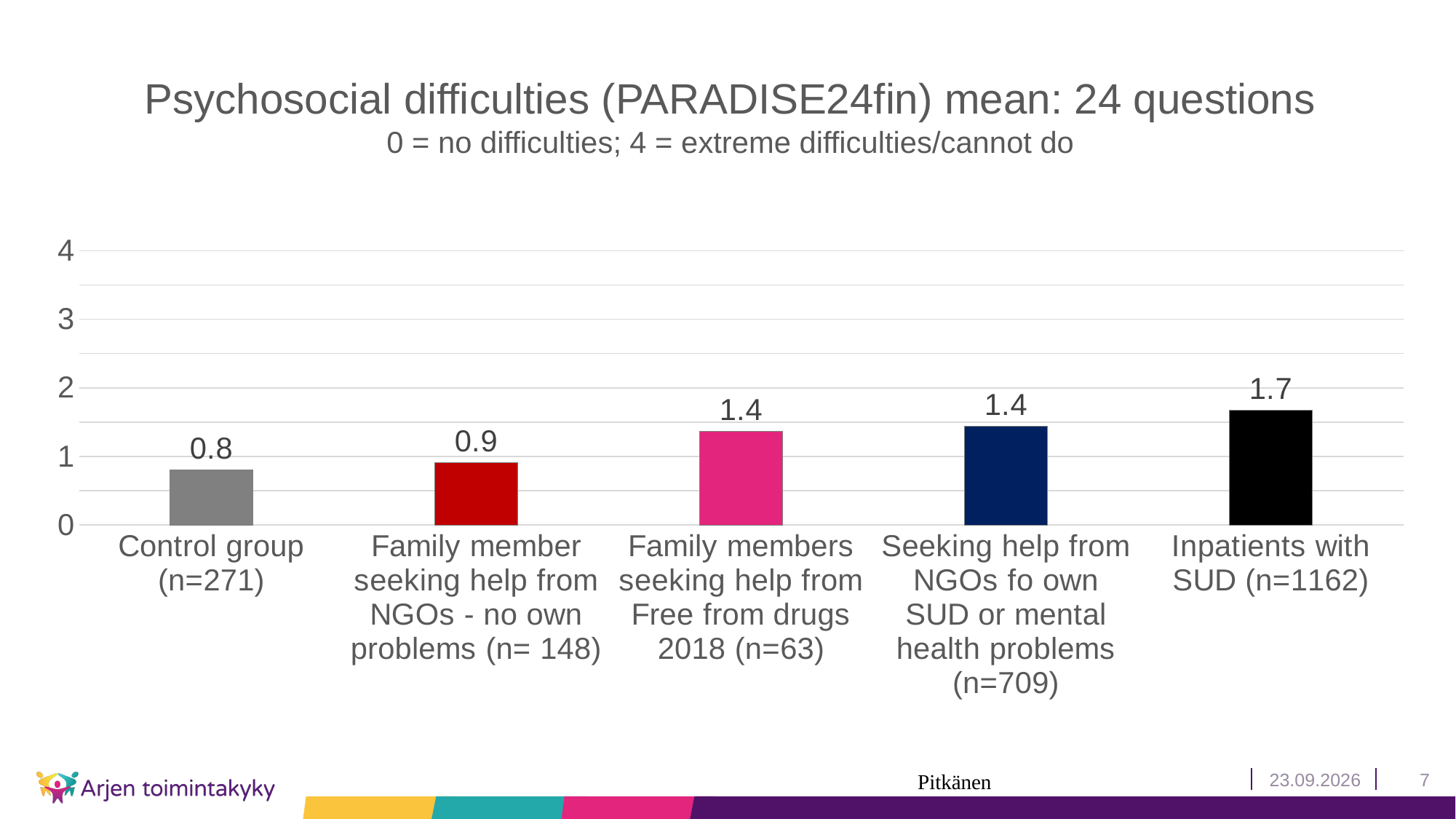
What is the mean psychosocial difficulties value for the Control group (n=271)? 0.8 What is the value for Family members seeking help from Free from drugs 2018 (n=63)? 1.4 What is the value for Family member seeking help from NGOs - no own problems (n= 148)? 0.9 What kind of chart is shown on the slide? bar chart What is the title of the chart? Psychosocial difficulties (PARADISE24fin) mean: 24 questions Which group has the lowest mean value? Control group (n=271) Is the value for Inpatients with SUD (n=1162) greater or less than 2? less Which group has the highest mean value? Inpatients with SUD (n=1162) What is the difference between the value for Inpatients with SUD and the Control group? 0.9 What is the value for Inpatients with SUD (n=1162)? 1.7 How many groups are shown in the chart? 5 Which is larger: the value for Seeking help from NGOs fo own SUD or mental health problems (n=709) or the value for Family member seeking help from NGOs - no own problems (n= 148)? Seeking help from NGOs fo own SUD or mental health problems (n=709)